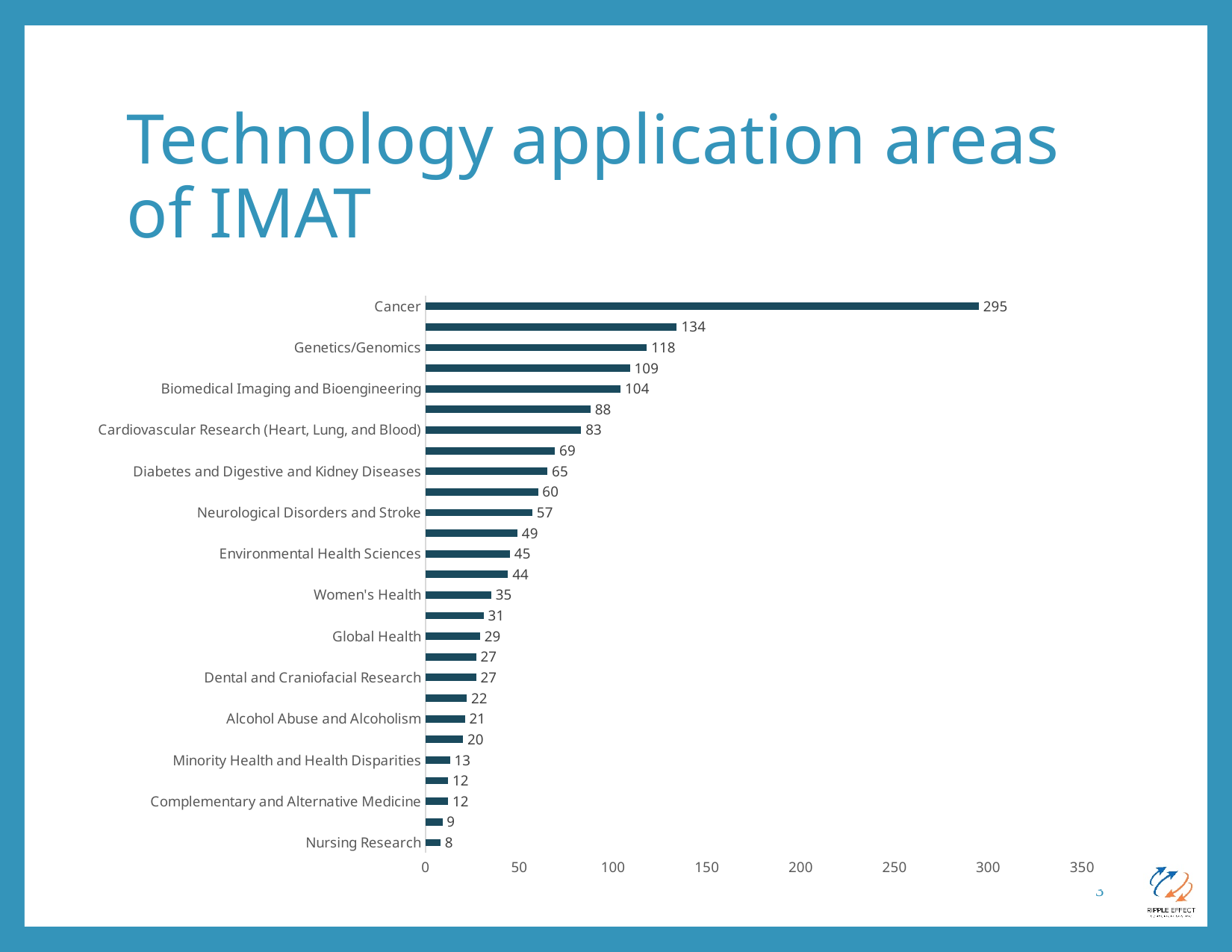
What is the difference between the values for Cancer and Genetics/Genomics? 177 What is the value for Biomedical Imaging and Bioengineering? 104 Which is larger, the value for Women's Health or the value for Global Health? Women's Health Is the value for Cardiovascular Research (Heart, Lung, and Blood) greater or less than 100? less What is the value for Neurological Disorders and Stroke? 57 What is the value for Genetics/Genomics? 118 What is the value for Cancer? 295 Which category has the highest value? Cancer Which category has the lowest value? Nursing Research What is the title of the slide containing the chart? Technology application areas of IMAT What is the value for Nursing Research? 8 What kind of chart is shown on the slide? bar chart